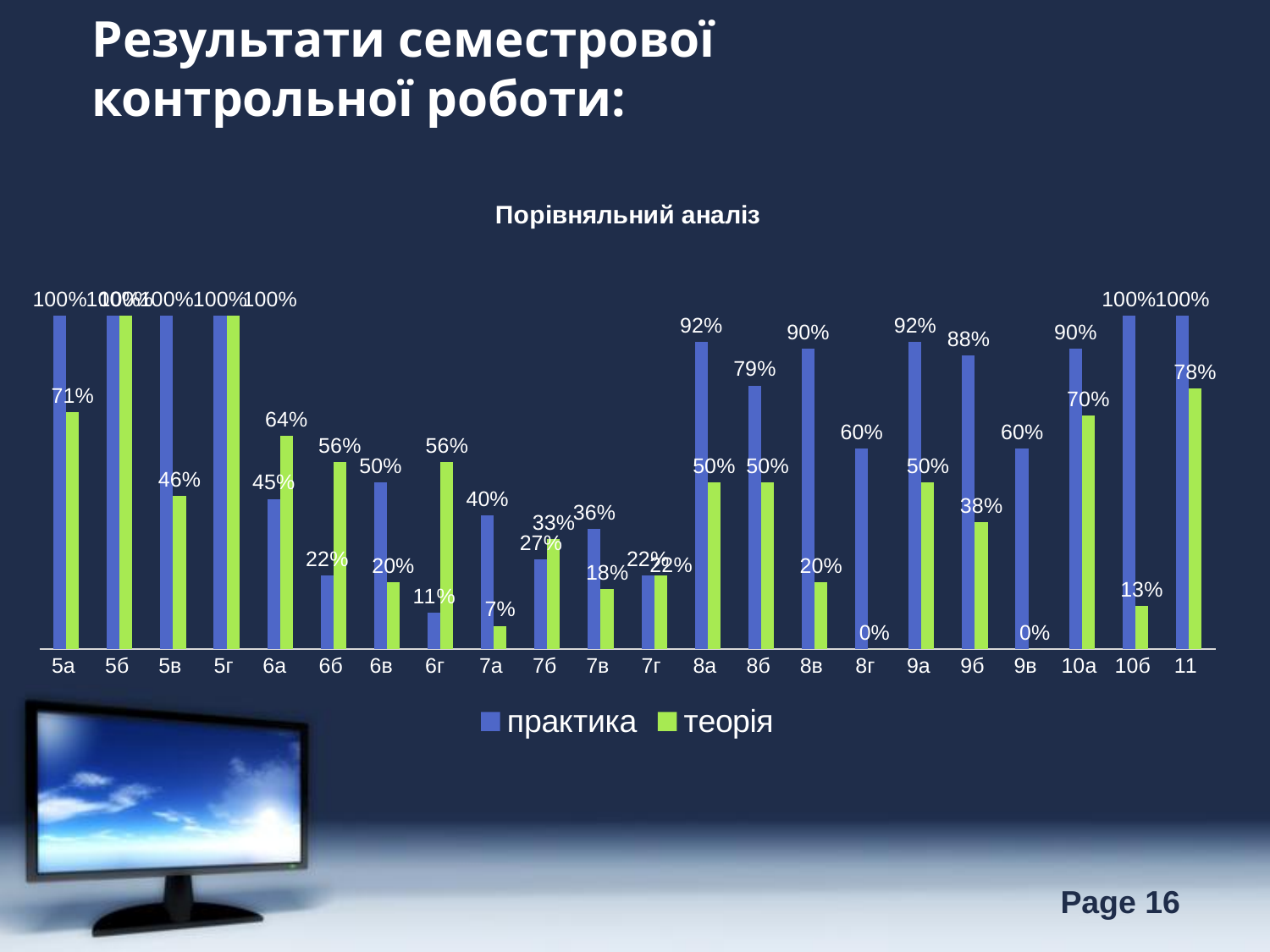
Which is larger for 6б, практика or теорія? теорія How many categories are shown on the x axis? 22 Which is larger for 9б, практика or теорія? практика What is the практика value for 6г? 11% What is the difference between the практика and теорія values for 8в? 70% What is the практика value for 8б? 79% What is the теорія value for 10б? 13% Which category has the lowest практика value? 6г What kind of chart is shown? bar chart How many series does the legend list? 2 What is the теорія value for 6а? 64% What is the title of the chart? Порівняльний аналіз